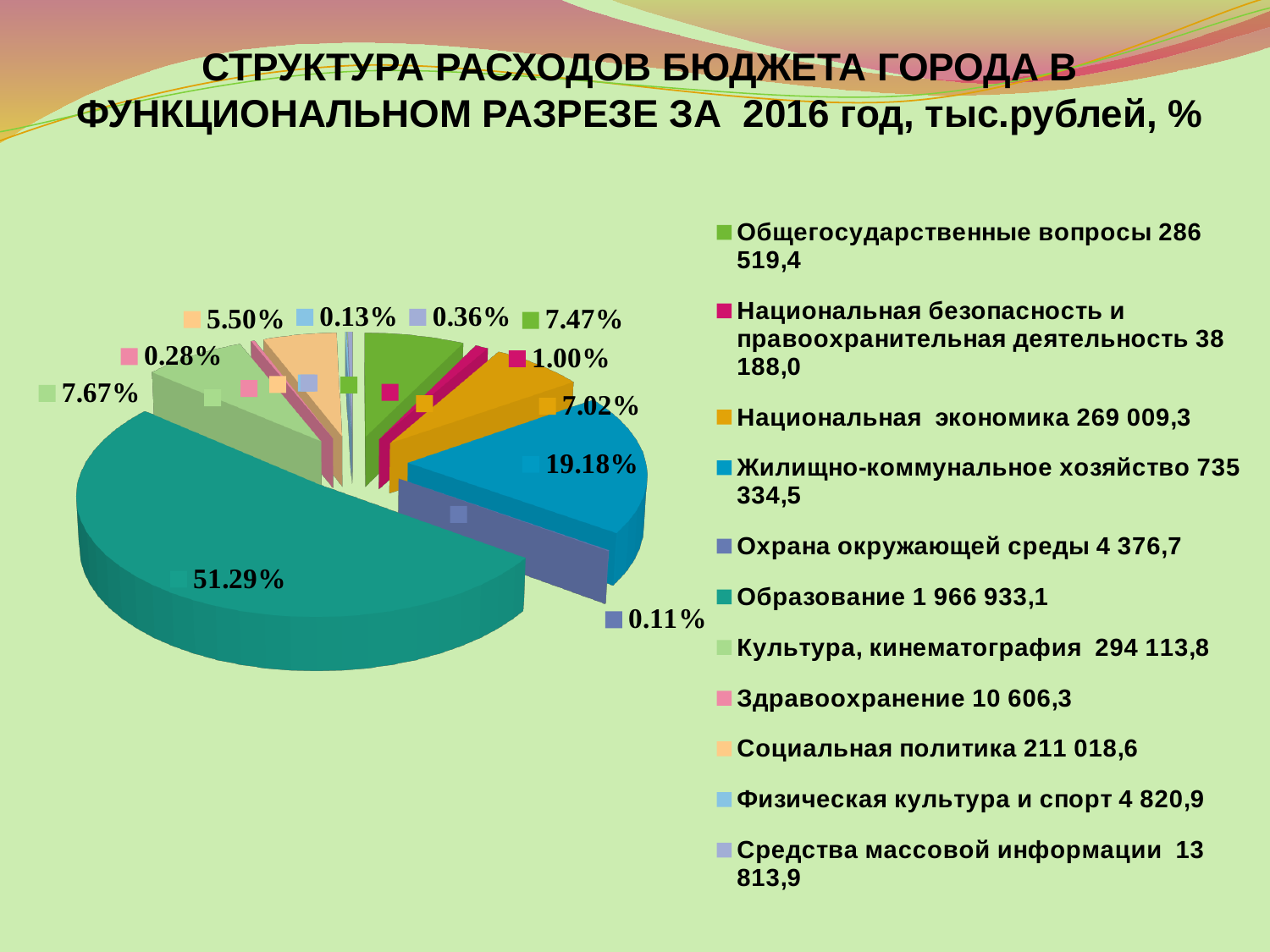
What is the difference in percentage points between Образование and Жилищно-коммунальное хозяйство? 32.11 What type of chart is shown on the slide? pie chart Which has a larger share: Культура, кинематография or Общегосударственные вопросы? Культура, кинематография What percentage is shown for Социальная политика? 5.50% What value in thousands of rubles is shown in the legend for Здравоохранение? 10 606,3 Which category has the largest share of the pie? Образование What share of the pie does Образование have? 51.29% What value in thousands of rubles is shown in the legend for Национальная экономика? 269 009,3 Which category has the smallest share of the pie? Охрана окружающей среды What share of the pie does Жилищно-коммунальное хозяйство have? 19.18% What year does the chart title refer to? 2016 How many categories does the pie chart have? 11